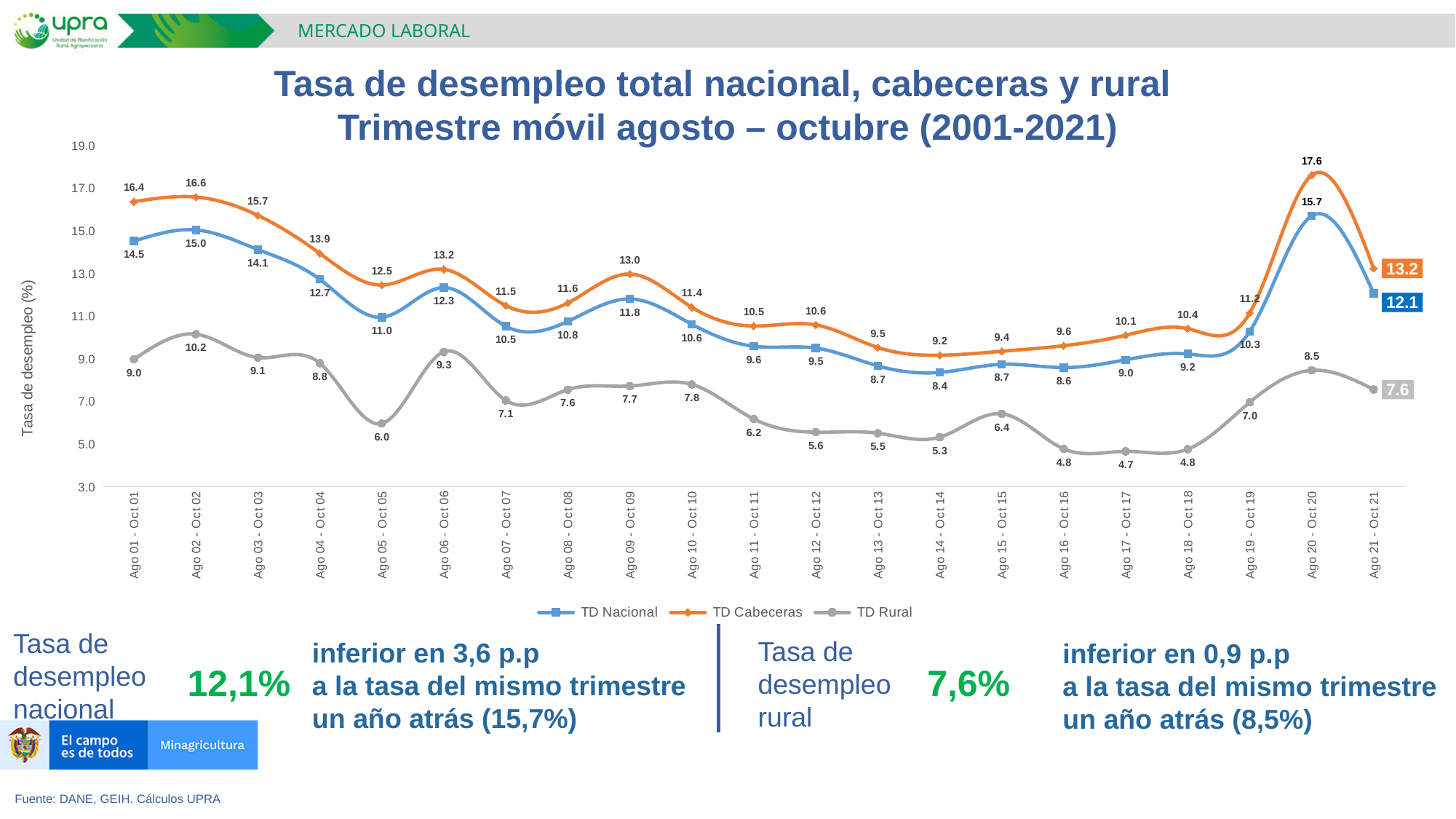
What kind of chart is shown on the slide? line chart Is the value of TD Cabeceras for Ago 20 - Oct 20 greater or less than 17.0? greater What is the value of TD Rural for Ago 05 - Oct 05? 6.0 Does TD Nacional rise or fall from Ago 02 - Oct 02 to Ago 05 - Oct 05? fall How many series does the legend list? 3 In which period does TD Rural reach its lowest value? Ago 17 - Oct 17 What is the value of TD Nacional for Ago 14 - Oct 14? 8.4 In which period does TD Nacional reach its highest value? Ago 20 - Oct 20 How many periods are shown on the x axis? 21 What is the value of TD Cabeceras for Ago 20 - Oct 20? 17.6 Which period has a higher TD Rural value: Ago 02 - Oct 02 or Ago 06 - Oct 06? Ago 02 - Oct 02 What is the difference between TD Cabeceras and TD Nacional in Ago 21 - Oct 21? 1.1